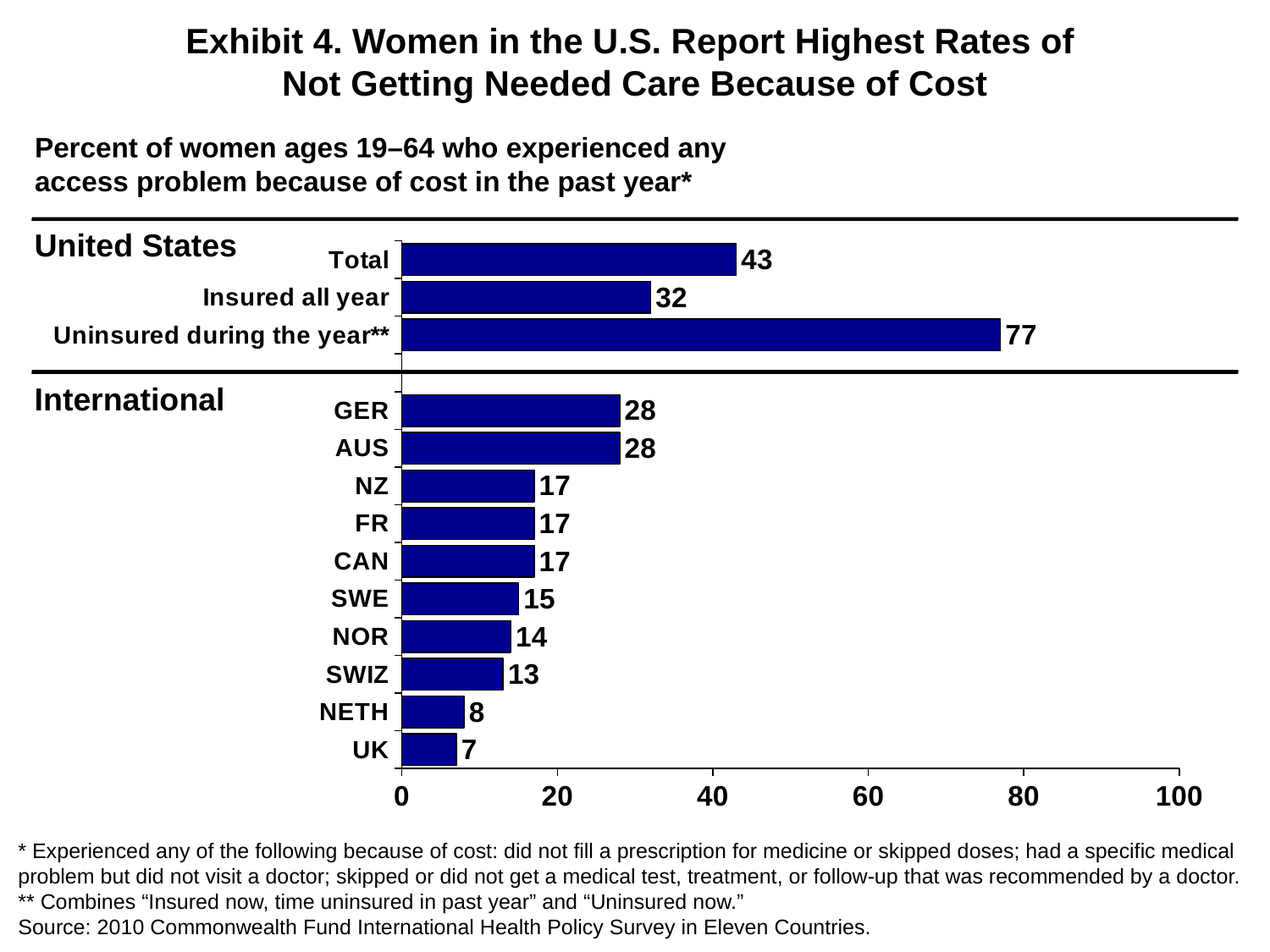
What is the highest tick value shown on the x axis? 100 Which is larger, the value for SWE or the value for NOR? SWE Which category has the highest value? Uninsured during the year** How many categories are plotted in the chart? 13 What kind of chart is shown on the slide? bar chart What is the value for Insured all year? 32 What is the value for NETH? 8 What is the value for CAN? 17 Which category has the lowest value? UK What is the difference between the values for Uninsured during the year** and Insured all year? 45 What is the difference between the values for GER and SWIZ? 15 What is the value for Uninsured during the year**? 77